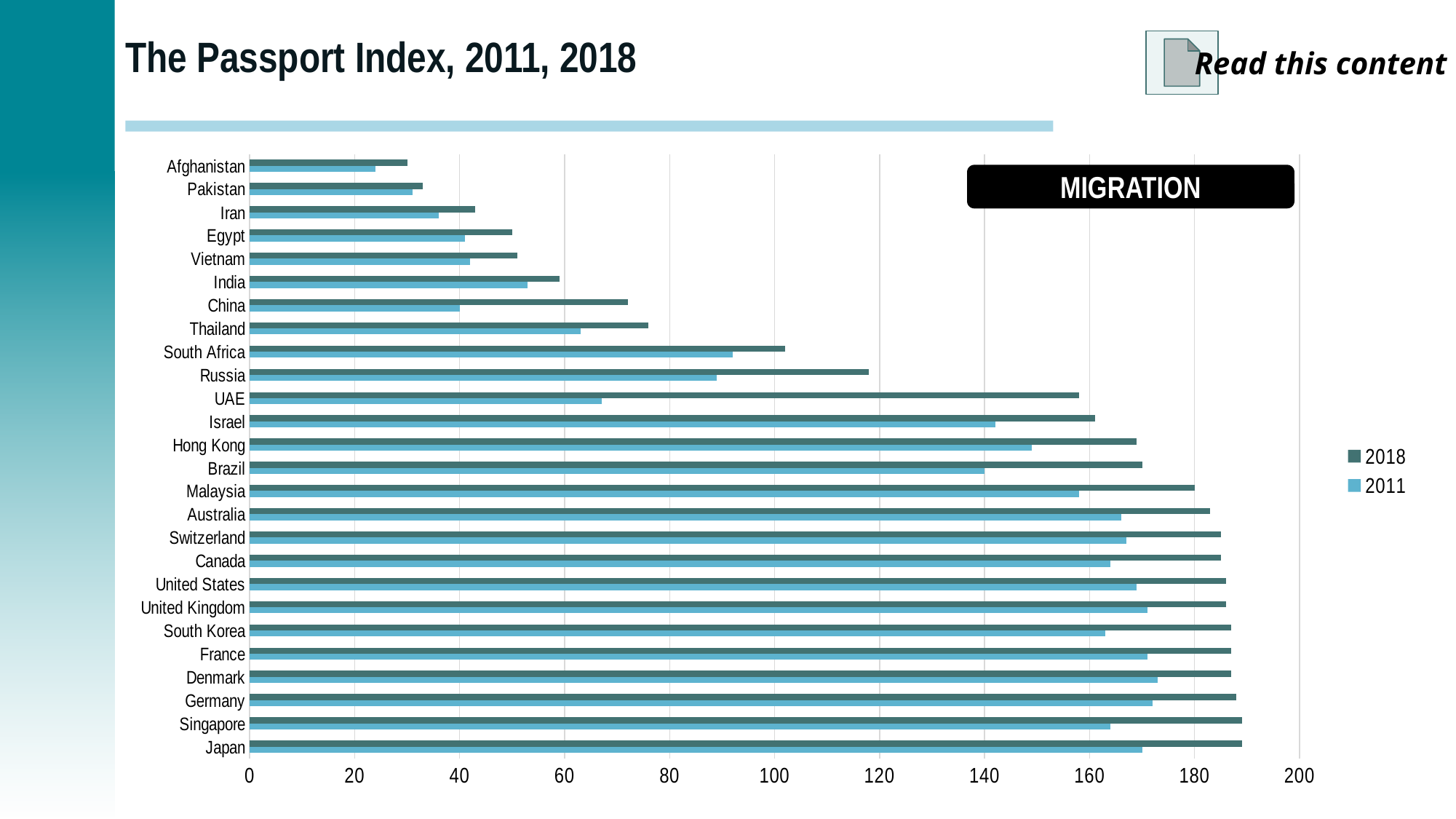
Which two series are listed in the legend? 2018 and 2011 Is the 2018 value for Afghanistan greater or less than 40? less Which has the larger 2011 value, China or Thailand? Thailand What kind of chart is shown on the slide? bar chart Is the 2018 value for Japan greater or less than 180? greater Is the 2018 value for China greater or less than 60? greater How many series does the legend list? 2 For UAE, which is larger: the 2018 value or the 2011 value? 2018 How many countries are plotted on the chart? 26 Which country has the lowest 2011 value? Afghanistan